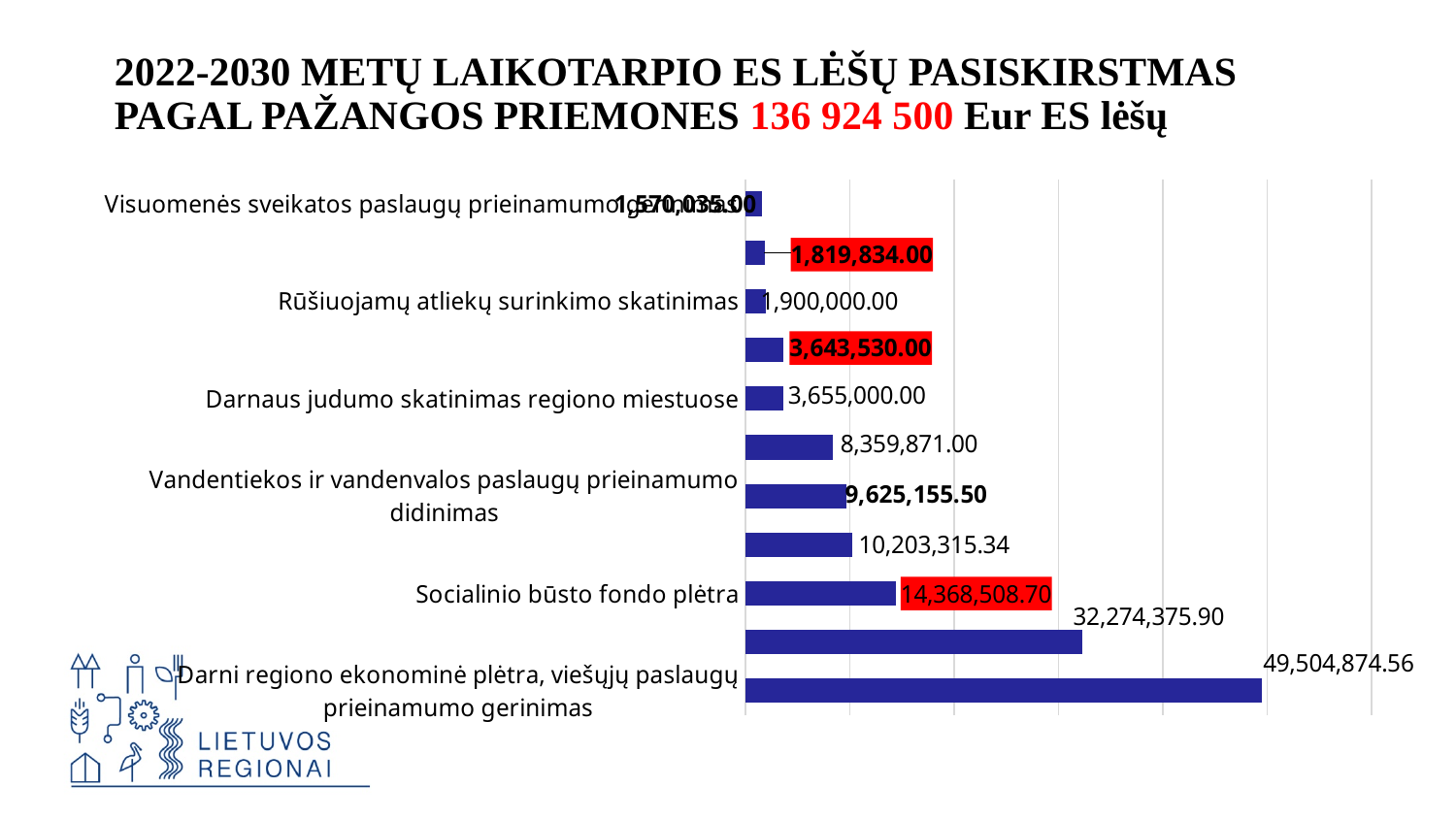
What kind of chart is shown on the slide? Bar chart What is the value for Darnaus judumo skatinimas regiono miestuose? 3,655,000.00 What is the difference between the values for Darni regiono ekonominė plėtra, viešųjų paslaugų prieinamumo gerinimas and Socialinio būsto fondo plėtra? 35,136,365.86 Which is larger, the value for Socialinio būsto fondo plėtra or the value for Darnaus judumo skatinimas regiono miestuose? Socialinio būsto fondo plėtra What is the value for Vandentiekos ir vandenvalos paslaugų prieinamumo didinimas? 9,625,155.50 What is the value for Rūšiuojamų atliekų surinkimo skatinimas? 1,900,000.00 How many bars are plotted in the chart? 11 Which category has the highest value? Darni regiono ekonominė plėtra, viešųjų paslaugų prieinamumo gerinimas What is the difference between the values for Darnaus judumo skatinimas regiono miestuose and Rūšiuojamų atliekų surinkimo skatinimas? 1,755,000.00 What total amount of EU funds is stated in the slide title? 136 924 500 Eur What is the value for Socialinio būsto fondo plėtra? 14,368,508.70 What is the value for Darni regiono ekonominė plėtra, viešųjų paslaugų prieinamumo gerinimas? 49,504,874.56